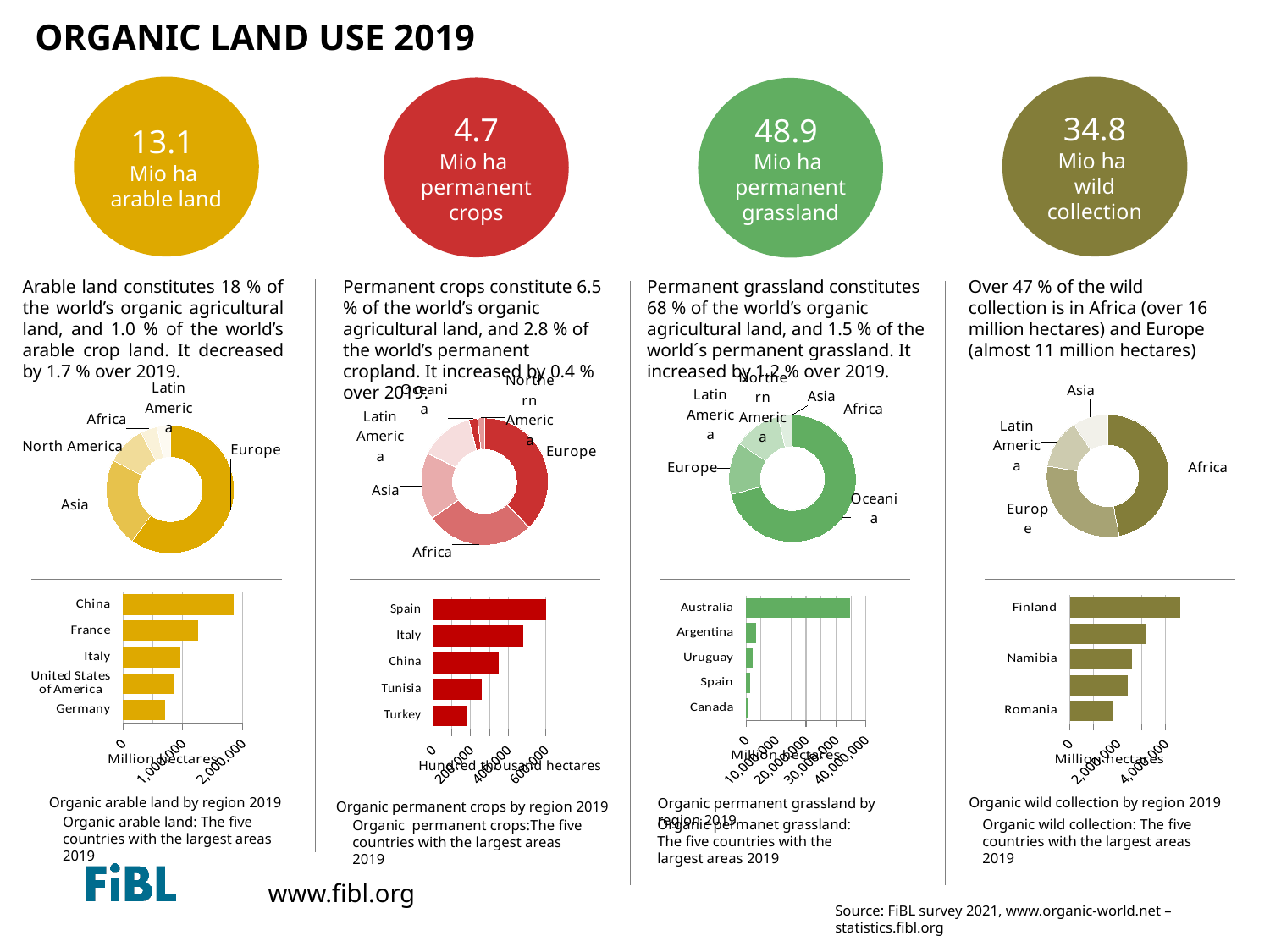
How many countries are shown in the chart 'Organic arable land: The five countries with the largest areas 2019'? 5 In the chart 'Organic permanent grassland: The five countries with the largest areas 2019', which country has the largest area? Australia In the chart 'Organic wild collection: The five countries with the largest areas 2019', which country has the largest area? Finland In the chart 'Organic permanent grassland: The five countries with the largest areas 2019', is the value for Australia greater or less than 30,000,000 hectares? greater In the chart 'Organic wild collection by region 2019', which region has the largest share? Africa In the chart 'Organic arable land: The five countries with the largest areas 2019', is the value for China greater or less than 1,000,000 hectares? greater In the chart 'Organic arable land: The five countries with the largest areas 2019', which country has the smallest area? Germany